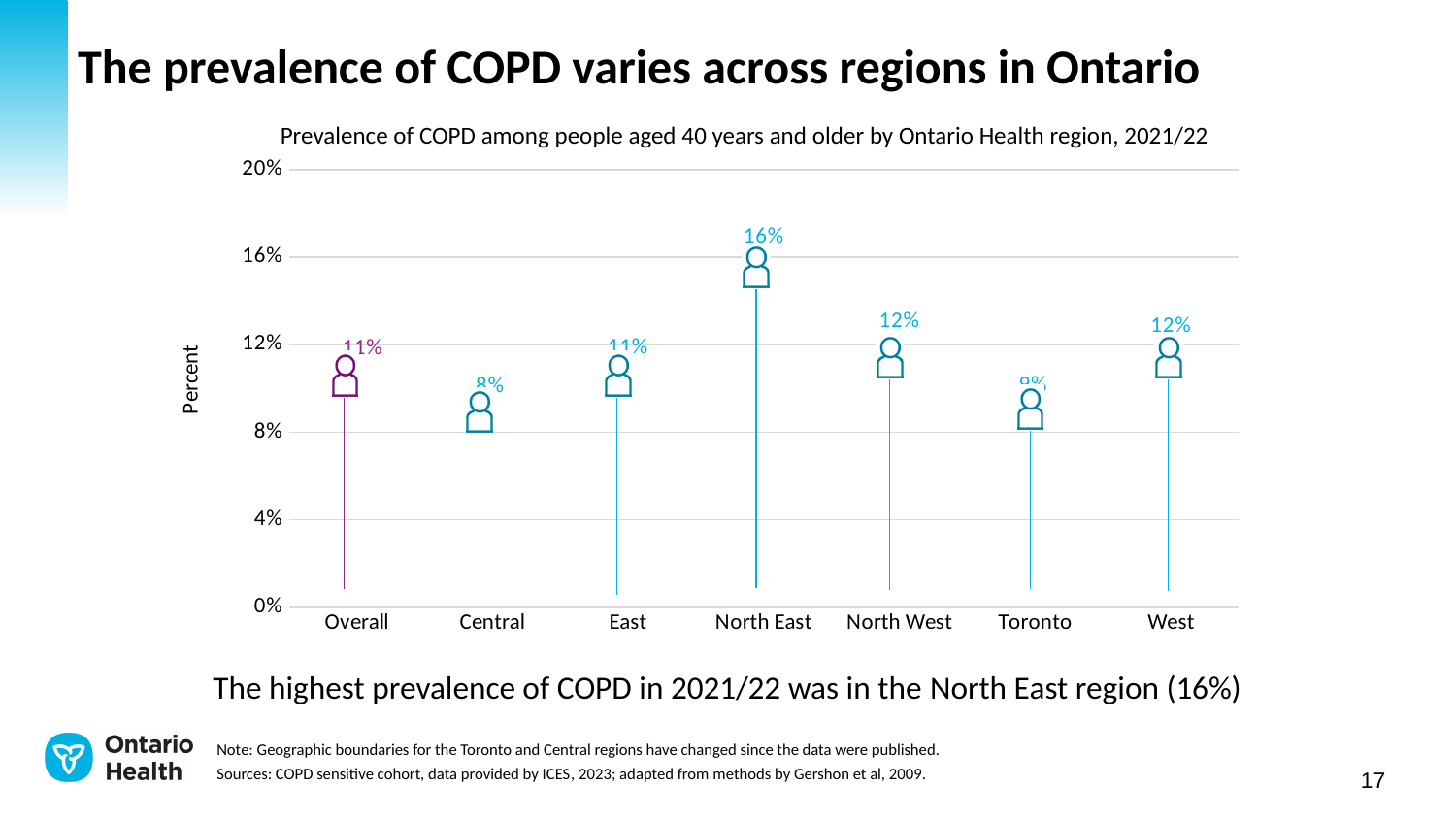
What is the prevalence of COPD in the East region? 11% Which has a higher COPD prevalence, North West or East? North West What is the Overall prevalence of COPD shown on the chart? 11% What is the prevalence of COPD in the West region? 12% How many categories are shown on the x axis of the chart? 7 Is the value for Toronto greater or less than 12%? less Which region has the highest prevalence of COPD? North East What is the prevalence of COPD in the North West region? 12% What is the prevalence of COPD in the North East region? 16% How many percentage points higher is the North East prevalence than the Overall prevalence? 5 percentage points What is the label on the y axis of the chart? Percent How many percentage points higher is the North East prevalence than the West prevalence? 4 percentage points